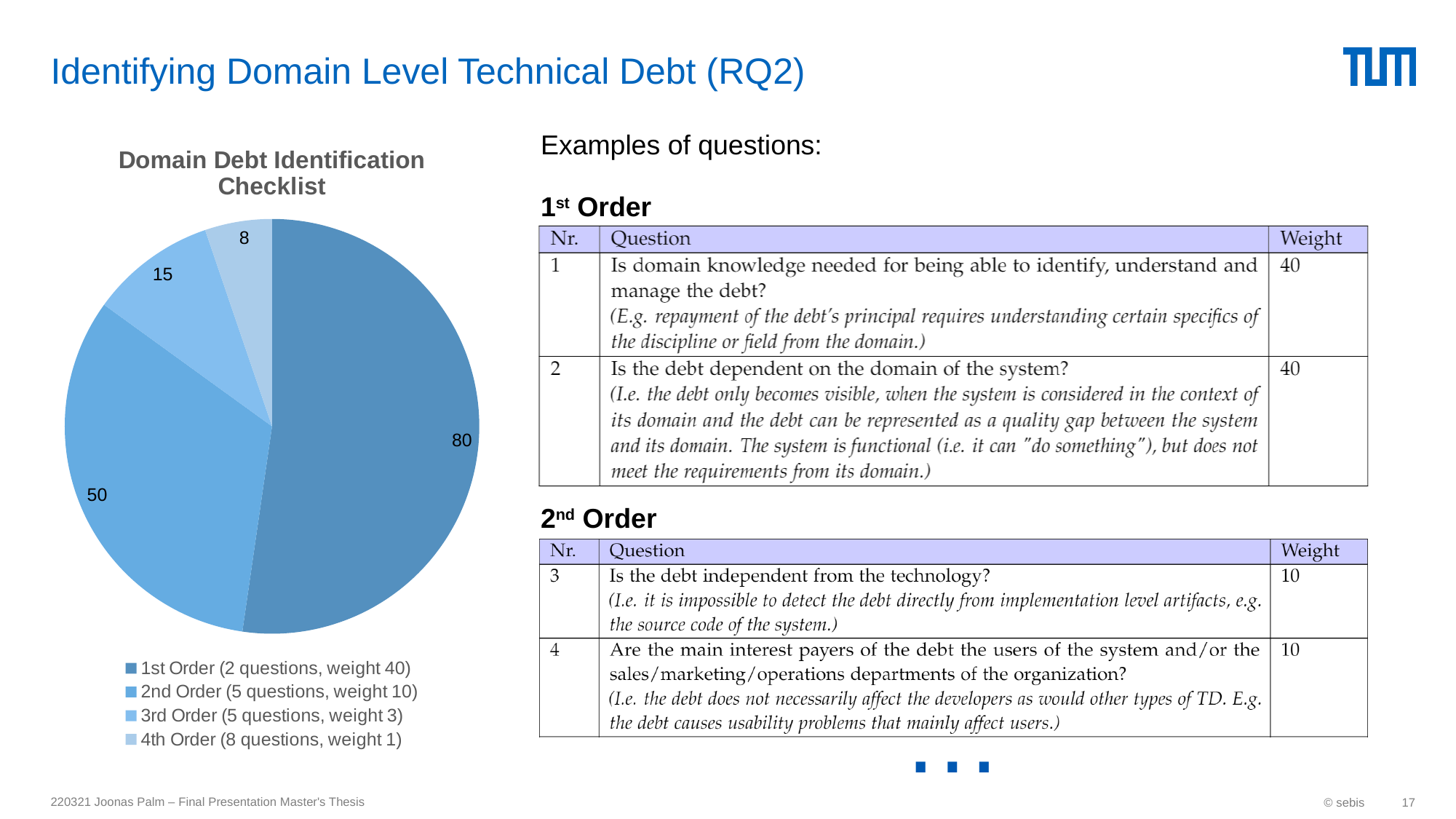
Which category has the smallest slice in the Domain Debt Identification Checklist pie chart? 4th Order According to the legend of the Domain Debt Identification Checklist pie chart, how many questions does the 4th Order contain? 8 questions What type of chart is the Domain Debt Identification Checklist chart? pie chart What is the value of the 3rd Order slice in the Domain Debt Identification Checklist pie chart? 15 What is the value of the 1st Order slice in the Domain Debt Identification Checklist pie chart? 80 How many slices does the Domain Debt Identification Checklist pie chart have? 4 What is the total of all slice values in the Domain Debt Identification Checklist pie chart? 153 What is the difference between the 1st Order and 2nd Order values in the Domain Debt Identification Checklist pie chart? 30 What is the value of the 4th Order slice in the Domain Debt Identification Checklist pie chart? 8 Which is larger in the Domain Debt Identification Checklist pie chart, the 3rd Order slice or the 4th Order slice? 3rd Order Which category has the largest slice in the Domain Debt Identification Checklist pie chart? 1st Order What is the value of the 2nd Order slice in the Domain Debt Identification Checklist pie chart? 50